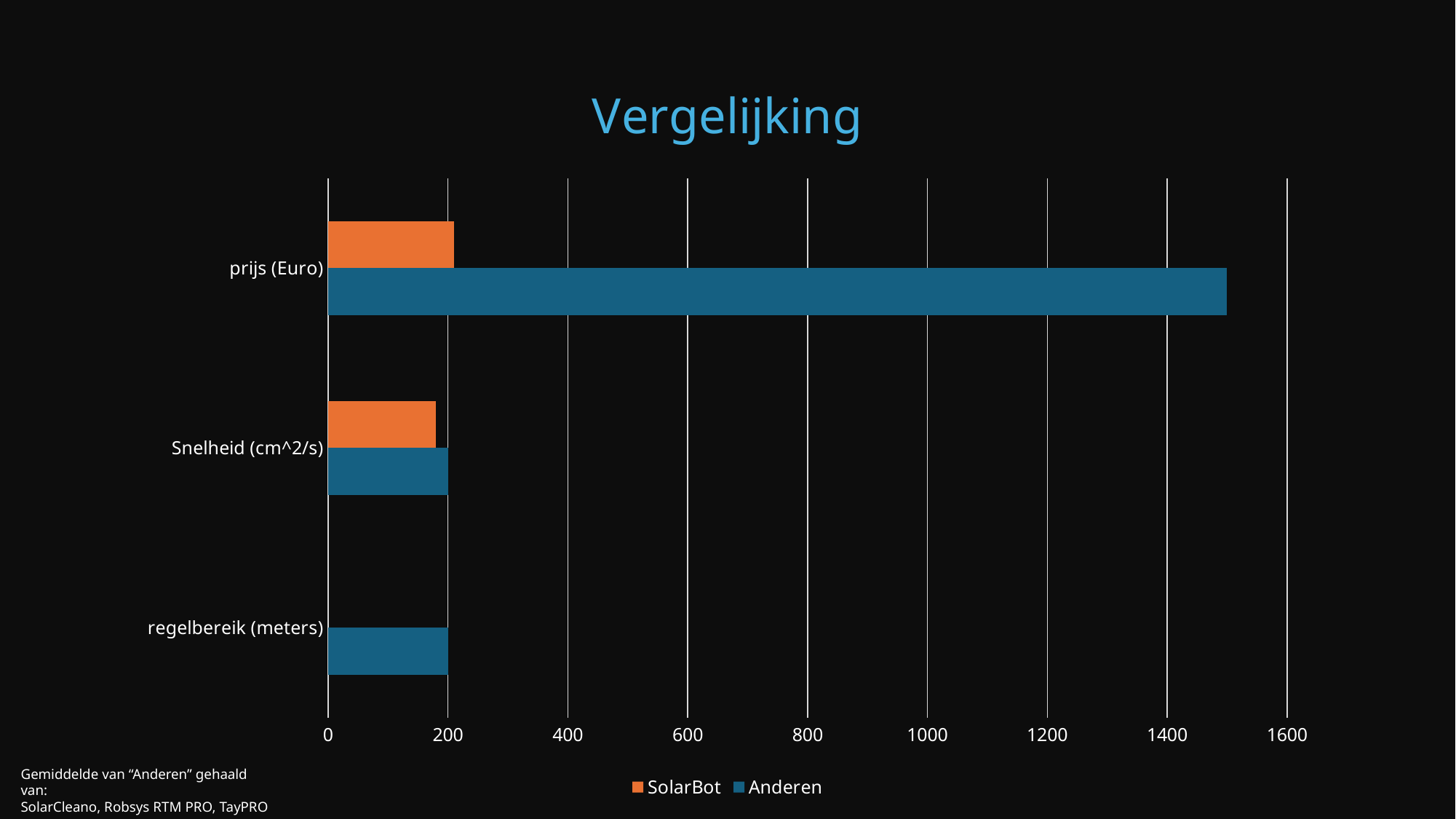
What kind of chart is shown on the slide? bar chart In the prijs (Euro) category, which series has the larger value, SolarBot or Anderen? Anderen Is the value for SolarBot in the Snelheid (cm^2/s) category greater or less than 200? less What is the title of the chart? Vergelijking Which colour represents the SolarBot series? orange Is the value for Anderen in the prijs (Euro) category greater or less than 1400? greater How many series does the legend list? 2 What is the value for Anderen in the Snelheid (cm^2/s) category? 200 What is the value for Anderen in the regelbereik (meters) category? 200 How many categories are shown on the chart? 3 Is the value for SolarBot in the prijs (Euro) category greater or less than 400? less For the Anderen series, which category has the highest value? prijs (Euro)